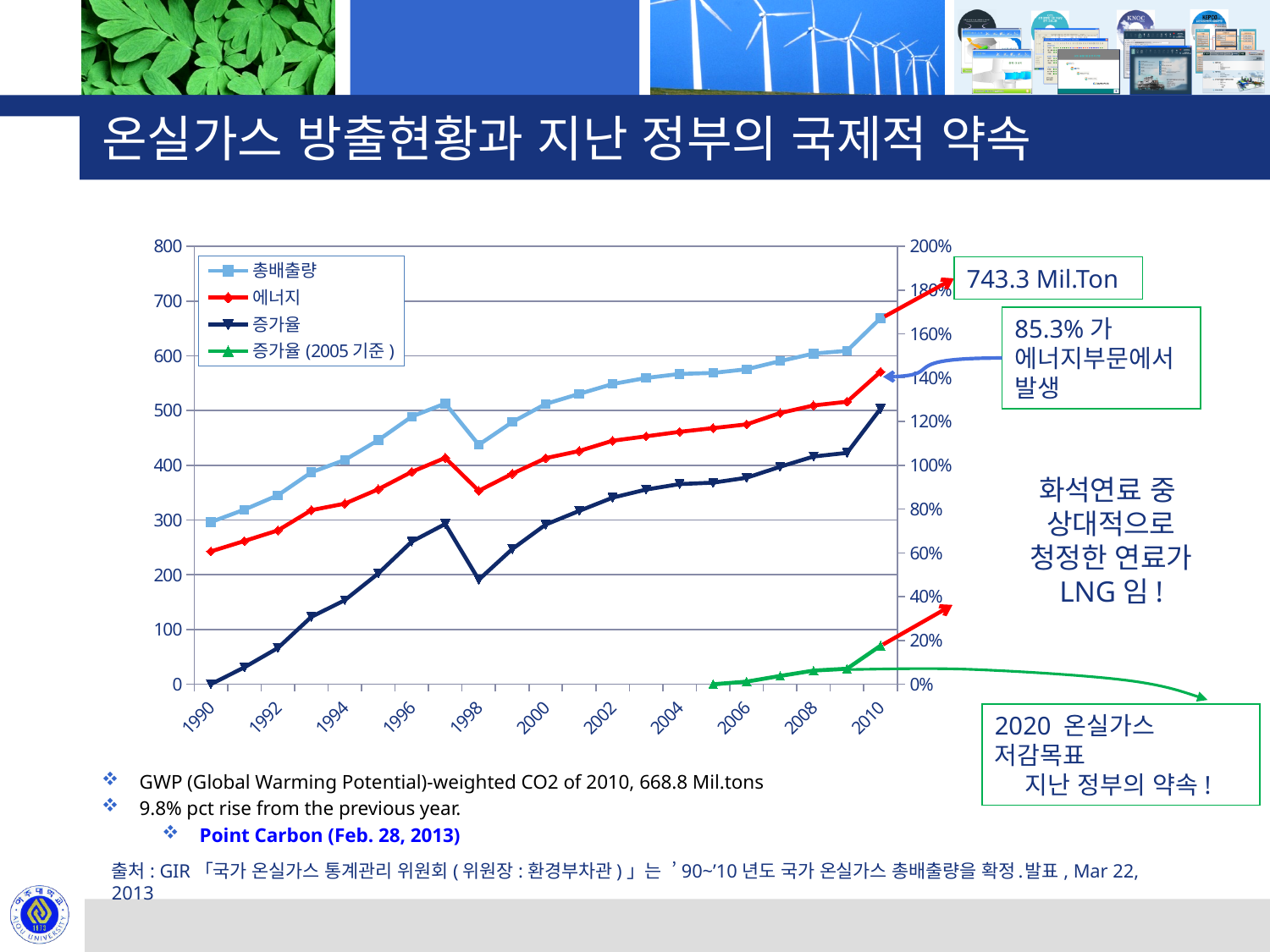
Is the value for 총배출량 in 1998 greater or less than 500? less How many series does the chart legend list? 4 Is the value for 총배출량 in 2010 greater or less than 600? greater In which year is the 총배출량 series at its highest? 2010 What kind of chart is shown on the slide? line chart What is the highest value shown on the right-hand vertical axis of the chart? 200% In which year is the 총배출량 series at its lowest? 1990 In 2010, which series is higher, 총배출량 or 에너지? 총배출량 What is the first series listed in the chart legend? 총배출량 Is the value for 에너지 in 1990 greater or less than 300? less How many year labels are shown along the x axis of the chart? 11 Does the 총배출량 series generally rise or fall from 1990 to 2010? rise